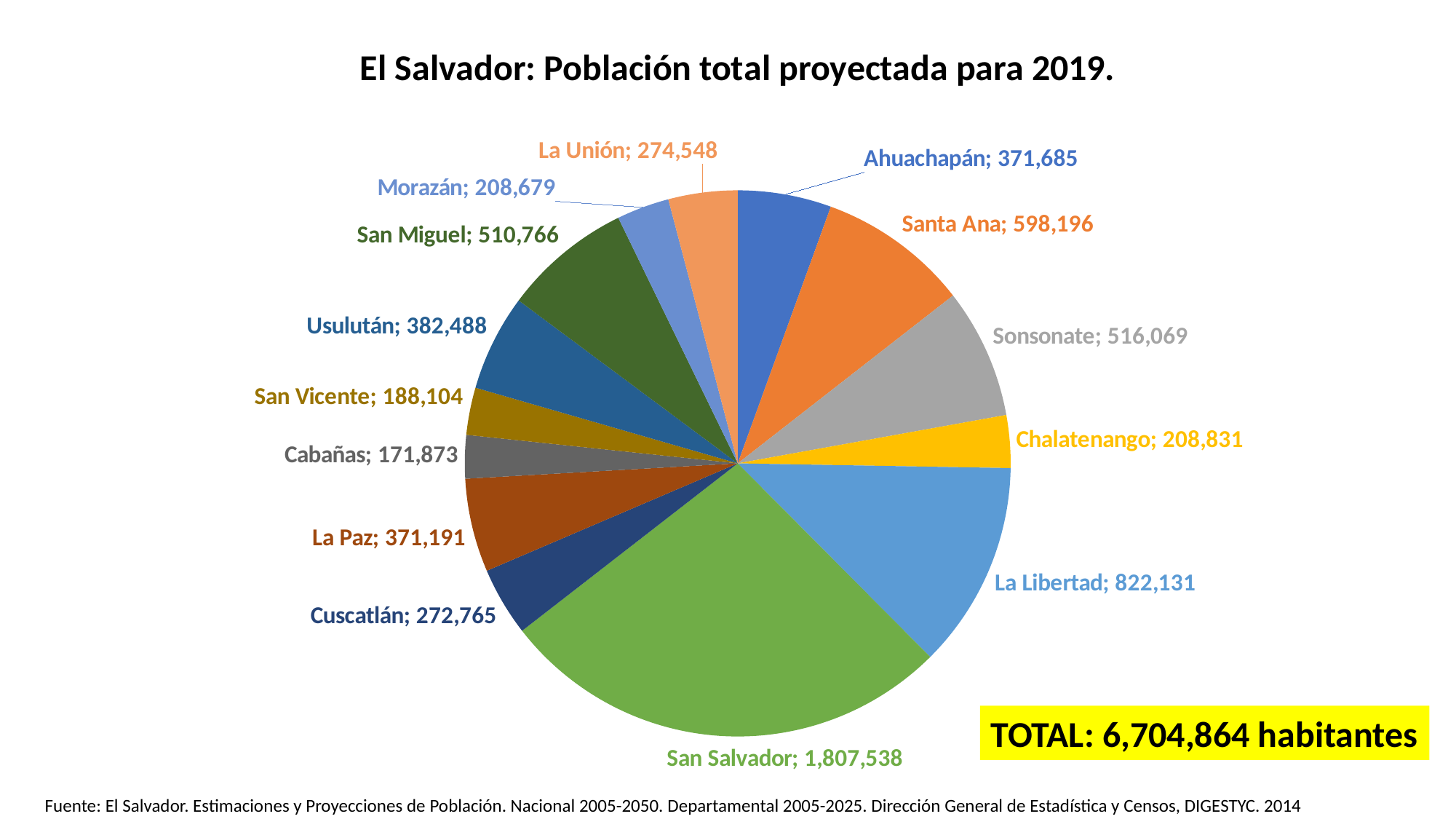
What is the difference between the populations of La Libertad and Santa Ana? 223,935 What is the title of the chart? El Salvador: Población total proyectada para 2019. What is the projected population shown for Santa Ana? 598,196 What is the difference between the populations of San Salvador and La Libertad? 985,407 Which department has the largest slice of the pie? San Salvador What value is shown for Usulután? 382,488 Which department has the smallest projected population? Cabañas What is the projected 2019 population of San Salvador? 1,807,538 What total population is stated on the slide? 6,704,864 habitantes Which has a larger projected population, Sonsonate or San Miguel? Sonsonate What type of chart is shown on the slide? Pie chart How many departments are shown in the pie chart? 14